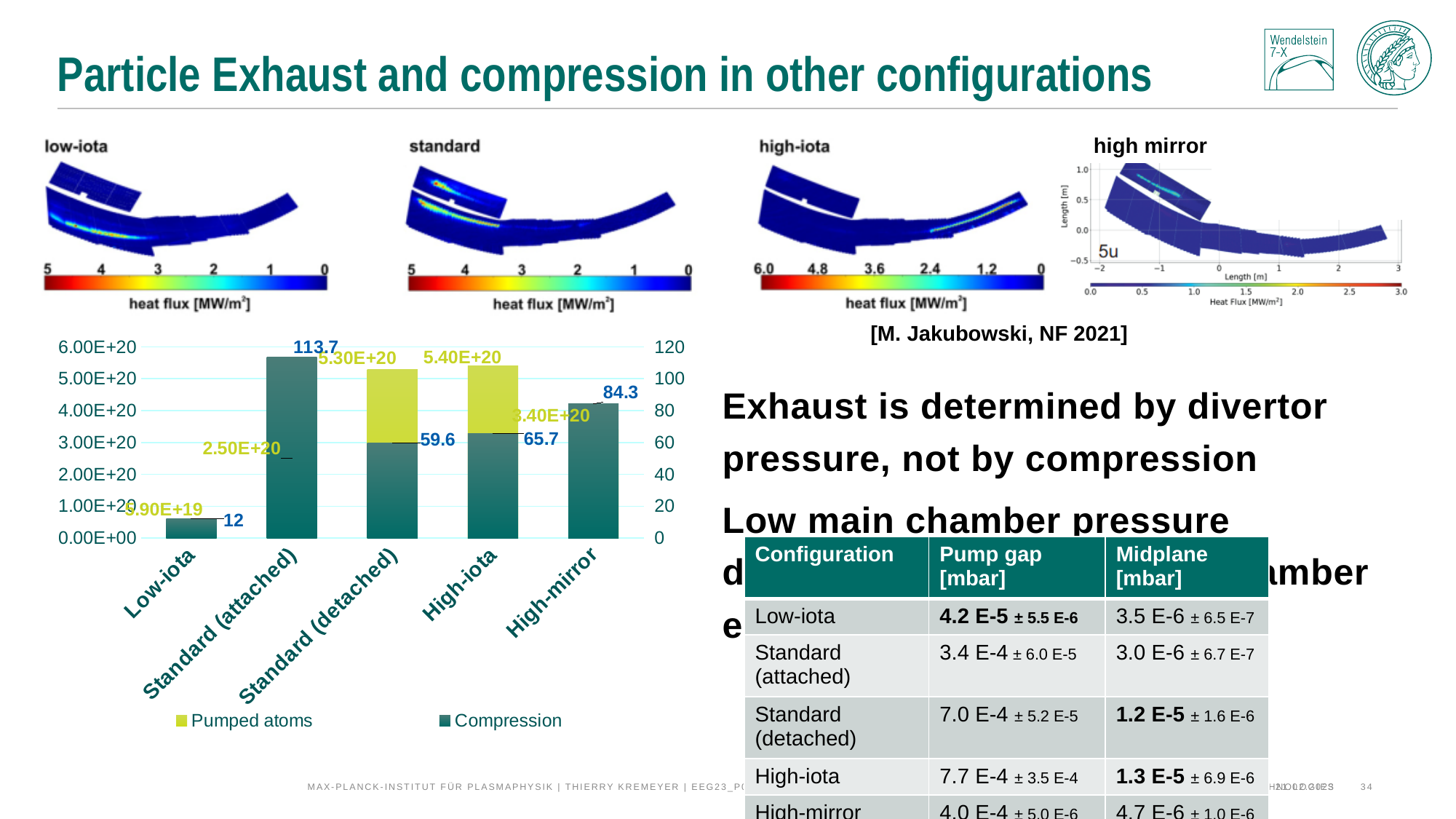
What is the Compression value for High-mirror? 84.3 Which has a larger Compression value, Standard (detached) or High-mirror? High-mirror What is the Compression value for Low-iota? 12 What is the Compression value for Standard (attached)? 113.7 Which configuration has the highest Compression value? Standard (attached) What is the difference in Compression between High-mirror and High-iota? 18.6 How many series does the legend of the bar chart list? 2 Which configuration has the lowest Compression value? Low-iota What is the Pumped atoms value for Low-iota? 5.90E+19 What is the Pumped atoms value for High-iota? 5.40E+20 What is the Pumped atoms value for Standard (detached)? 5.30E+20 How many configurations are shown on the x axis of the bar chart? 5